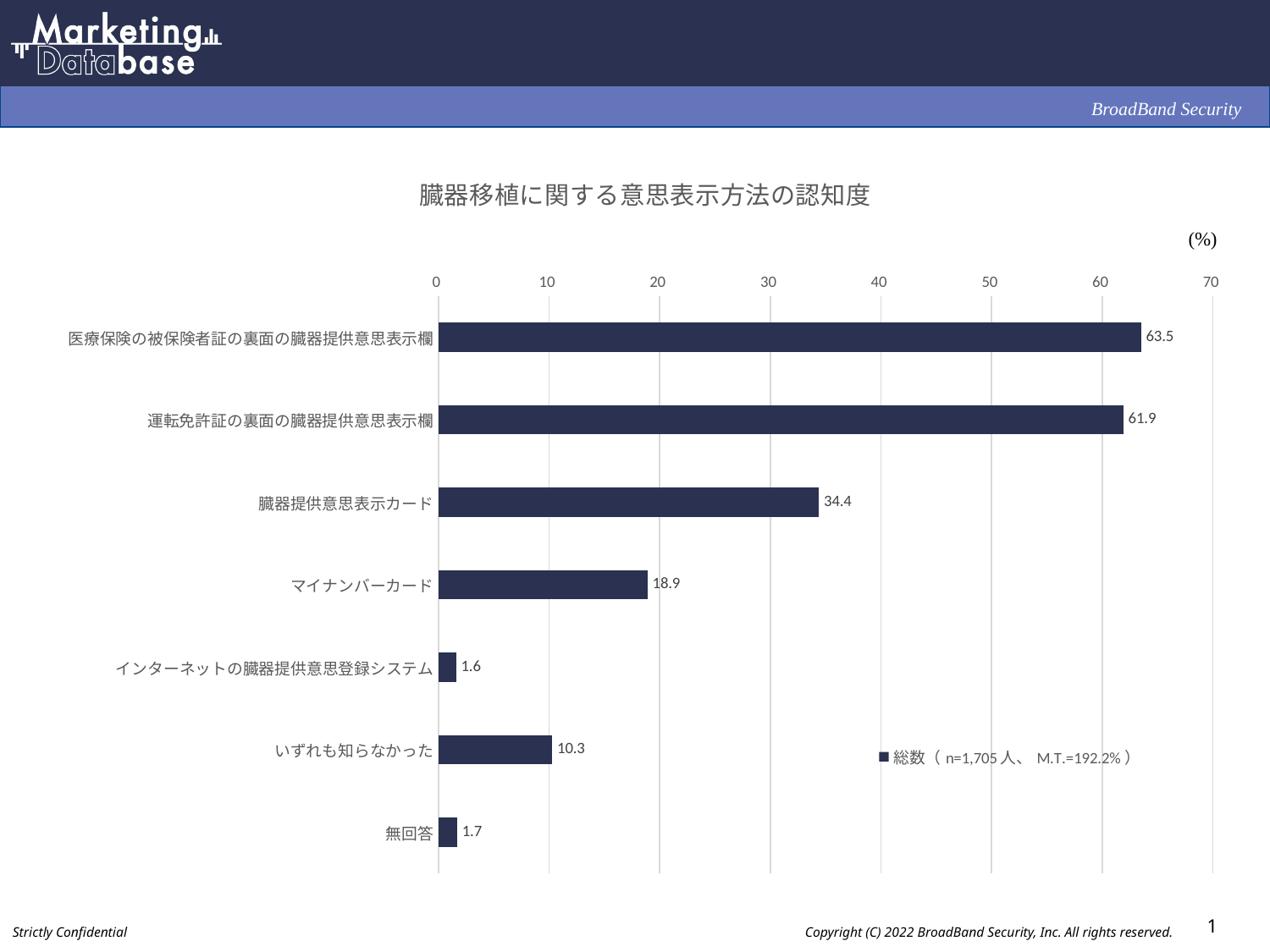
What is the title of the chart? 臓器移植に関する意思表示方法の認知度 Which category has the highest value? 医療保険の被保険者証の裏面の臓器提供意思表示欄 How many series does the legend list? 1 Which is larger, the value for 臓器提供意思表示カード or the value for マイナンバーカード? 臓器提供意思表示カード What is the value for 医療保険の被保険者証の裏面の臓器提供意思表示欄? 63.5 How many categories are shown in the chart? 7 What is the difference between the values for 運転免許証の裏面の臓器提供意思表示欄 and 臓器提供意思表示カード? 27.5 What is the value for マイナンバーカード? 18.9 Which category has the lowest value? インターネットの臓器提供意思登録システム Is the value for 運転免許証の裏面の臓器提供意思表示欄 greater or less than 50? greater What is the value for いずれも知らなかった? 10.3 What kind of chart is shown on the slide? bar chart